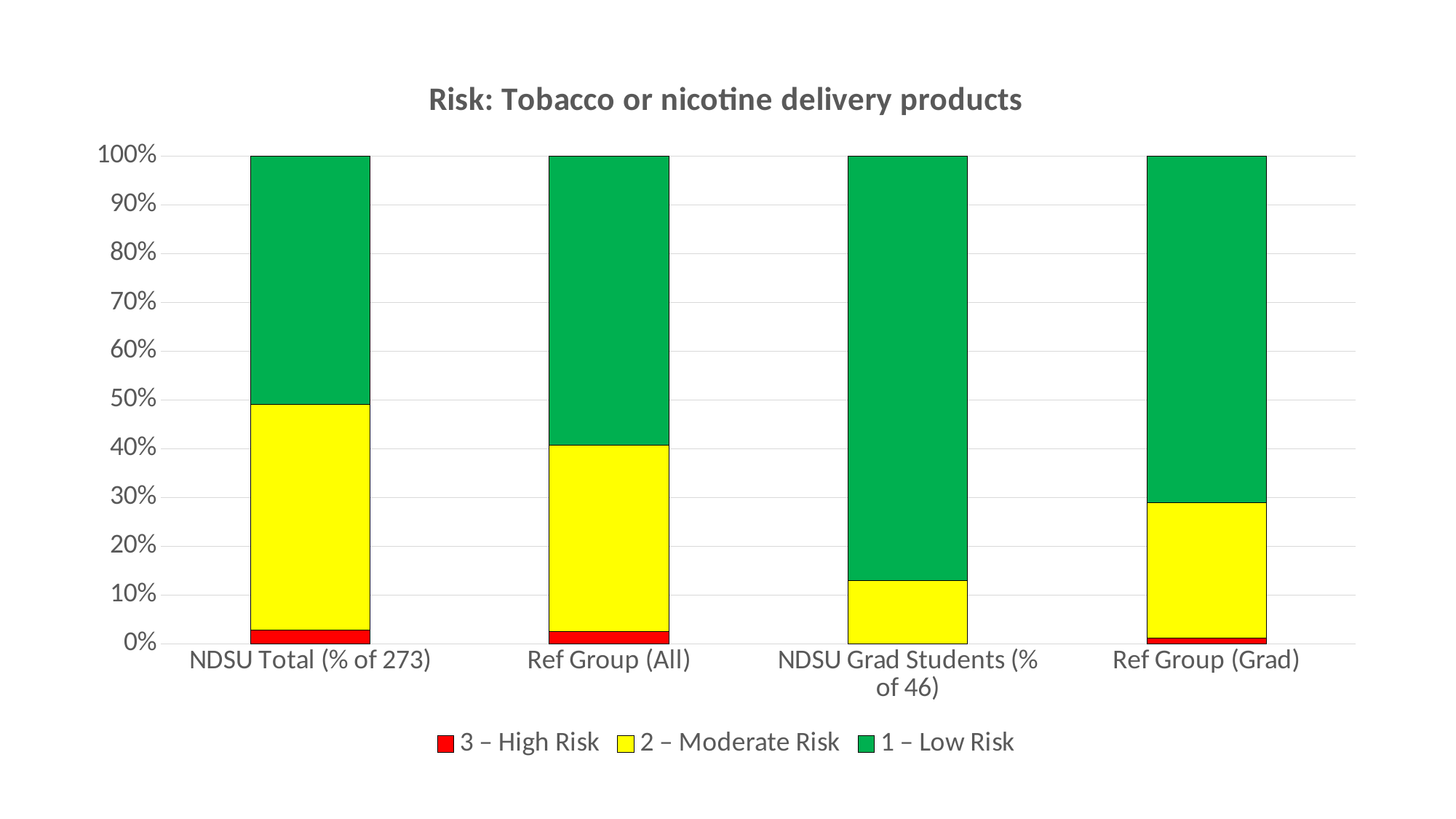
What type of chart is shown on the slide? Stacked bar chart How many series does the legend list? 3 How many categories are shown along the x axis? 4 Is the top of the 2 – Moderate Risk segment for Ref Group (Grad) greater or less than 40%? less What is the title of the chart? Risk: Tobacco or nicotine delivery products Is the top of the 2 – Moderate Risk segment for NDSU Total (% of 273) greater or less than 50%? less Which category has the largest 2 – Moderate Risk segment? NDSU Total (% of 273) Is the top of the 2 – Moderate Risk segment for NDSU Grad Students (% of 46) greater or less than 10%? greater What is the total height of the stacked bar for Ref Group (All)? 100% Which category has the largest 1 – Low Risk segment? NDSU Grad Students (% of 46) Is the 2 – Moderate Risk segment larger for NDSU Total (% of 273) or for Ref Group (Grad)? NDSU Total (% of 273) Which category has the smallest 2 – Moderate Risk segment? NDSU Grad Students (% of 46)